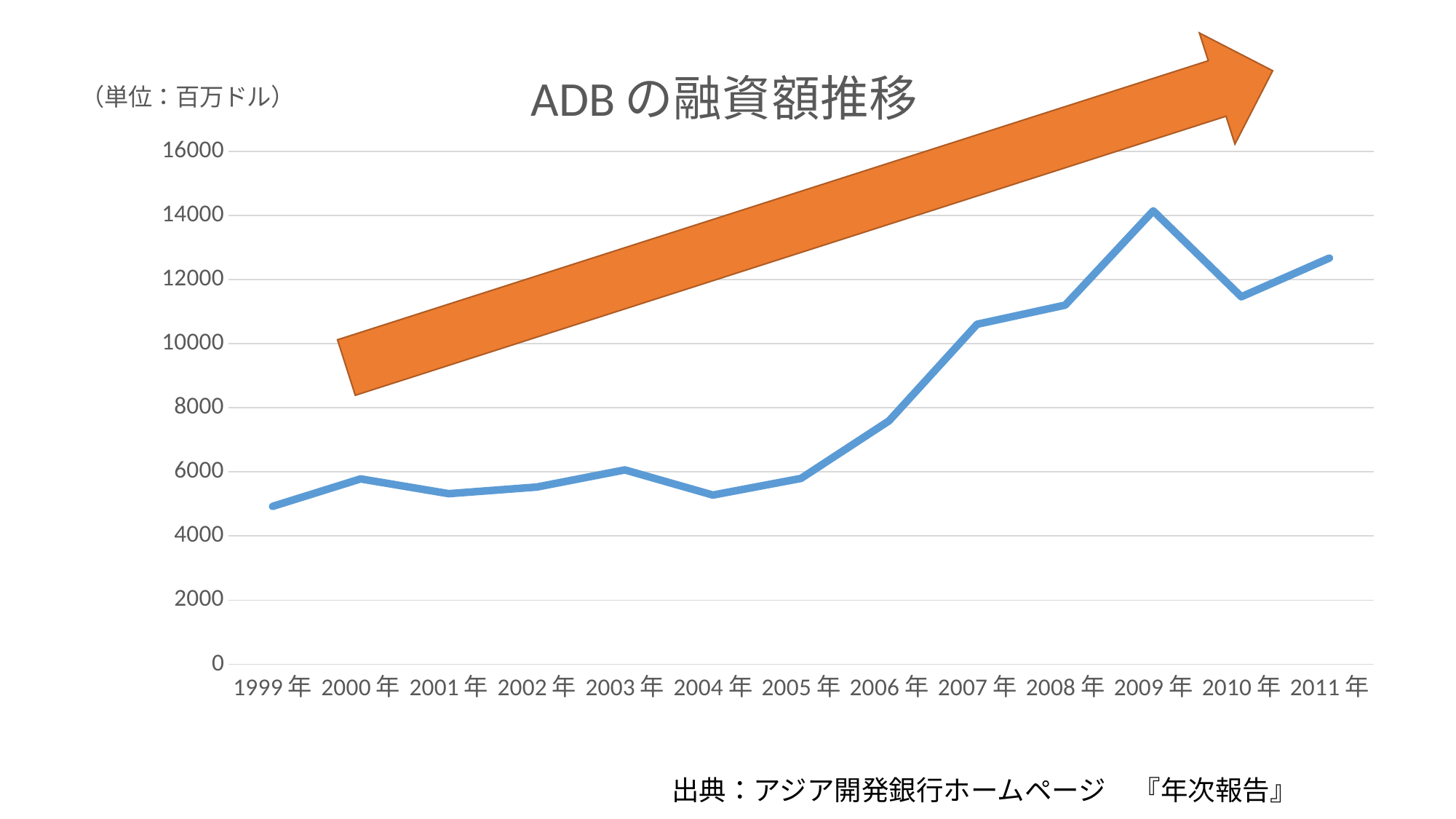
What unit is stated for the values in the chart? 百万ドル What is the title of the chart? ADBの融資額推移 Which year has the lowest value? 1999年 Which is larger, the value for 2009年 or the value for 2010年? 2009年 Is the value for 2006年 greater or less than 8000? less Which year has the highest value? 2009年 How many years are plotted along the x axis? 13 Is the value for 1999年 greater or less than 6000? less Overall, do the values rise or fall from 1999年 to 2011年? rise Is the value for 2009年 greater or less than 12000? greater What kind of chart is shown on the slide? line chart